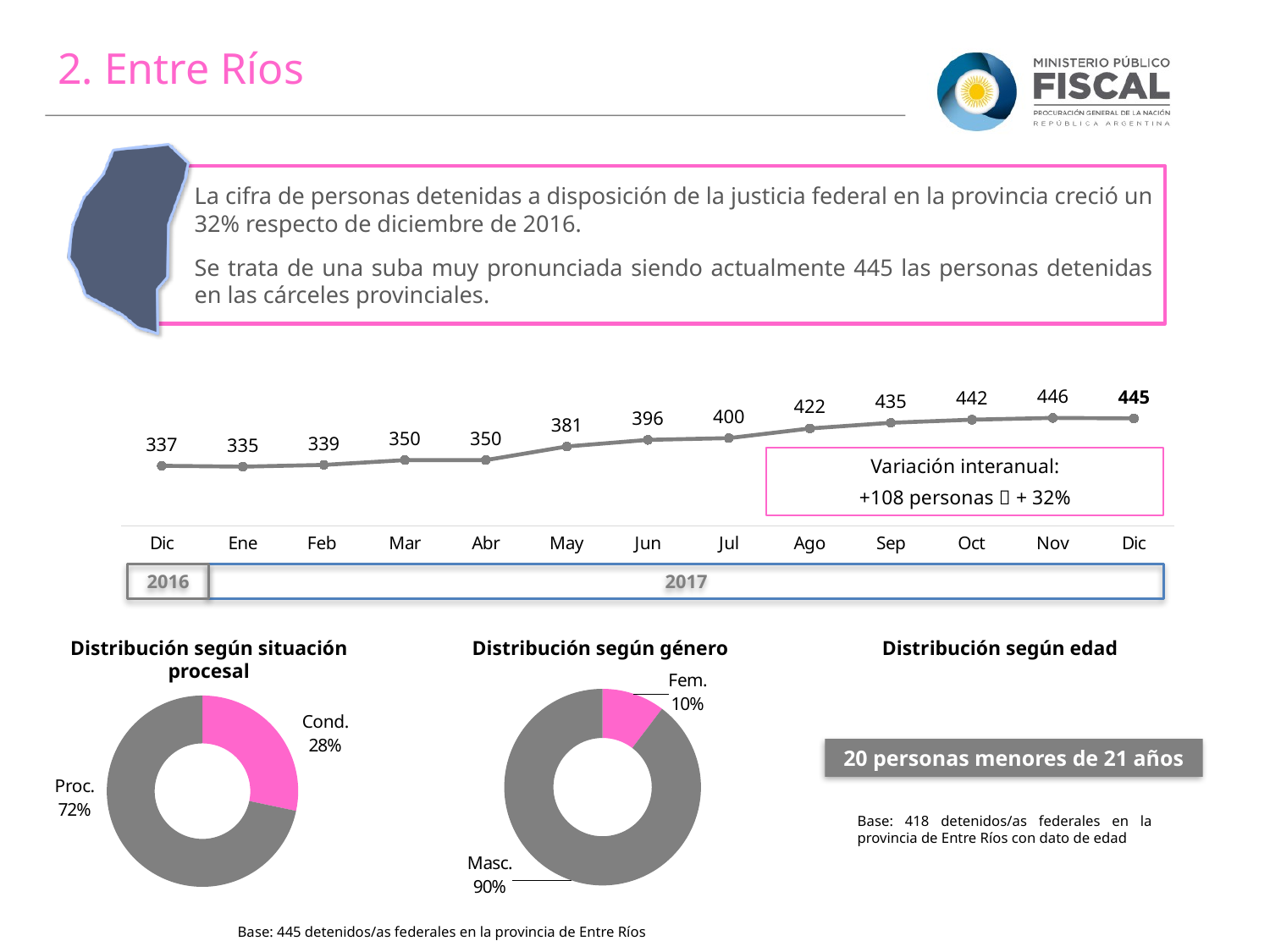
In the line chart, what is the value for Dic 2016? 337 In the line chart, which month has the highest value? Nov In the line chart, do the values generally rise or fall from Dic 2016 to Dic 2017? Rise In the 'Distribución según situación procesal' chart, what share is Cond.? 28% In the line chart, what is the difference between the values for Dic 2017 and Dic 2016? 108 How many data points are plotted in the line chart? 13 In the line chart, which month has the lowest value? Ene In the 'Distribución según género' chart, which category is larger, Fem. or Masc.? Masc. In the line chart, what is the value for Jul? 400 In the line chart, which is larger, the value for May or the value for Abr? May In the 'Distribución según género' chart, what share is Masc.? 90% What kind of chart shows the monthly values from Dic 2016 to Dic 2017? Line chart